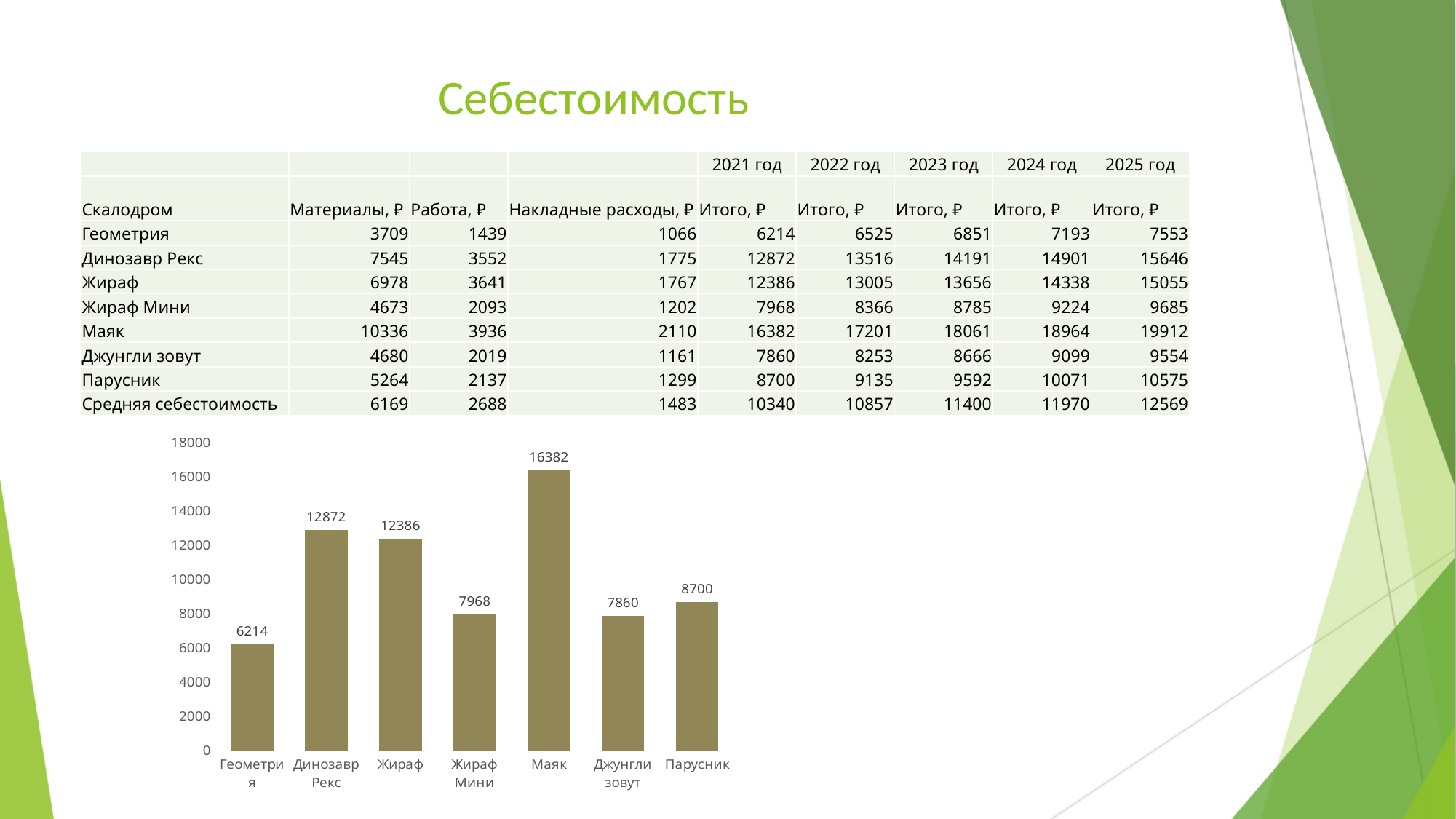
How many categories are shown in the bar chart? 7 Which is larger in the bar chart, Парусник or Джунгли зовут? Парусник What is the value for Парусник in the bar chart? 8700 Is the value for Динозавр Рекс in the bar chart greater or less than 12000? greater What is the difference between the values for Маяк and Геометрия in the bar chart? 10168 What is the difference between the values for Динозавр Рекс and Жираф in the bar chart? 486 Which category has the lowest value in the bar chart? Геометрия Which category has the highest value in the bar chart? Маяк What kind of chart is shown on the slide? bar chart What is the value for Жираф Мини in the bar chart? 7968 What is the title of the slide? Себестоимость What is the value for Маяк in the bar chart? 16382